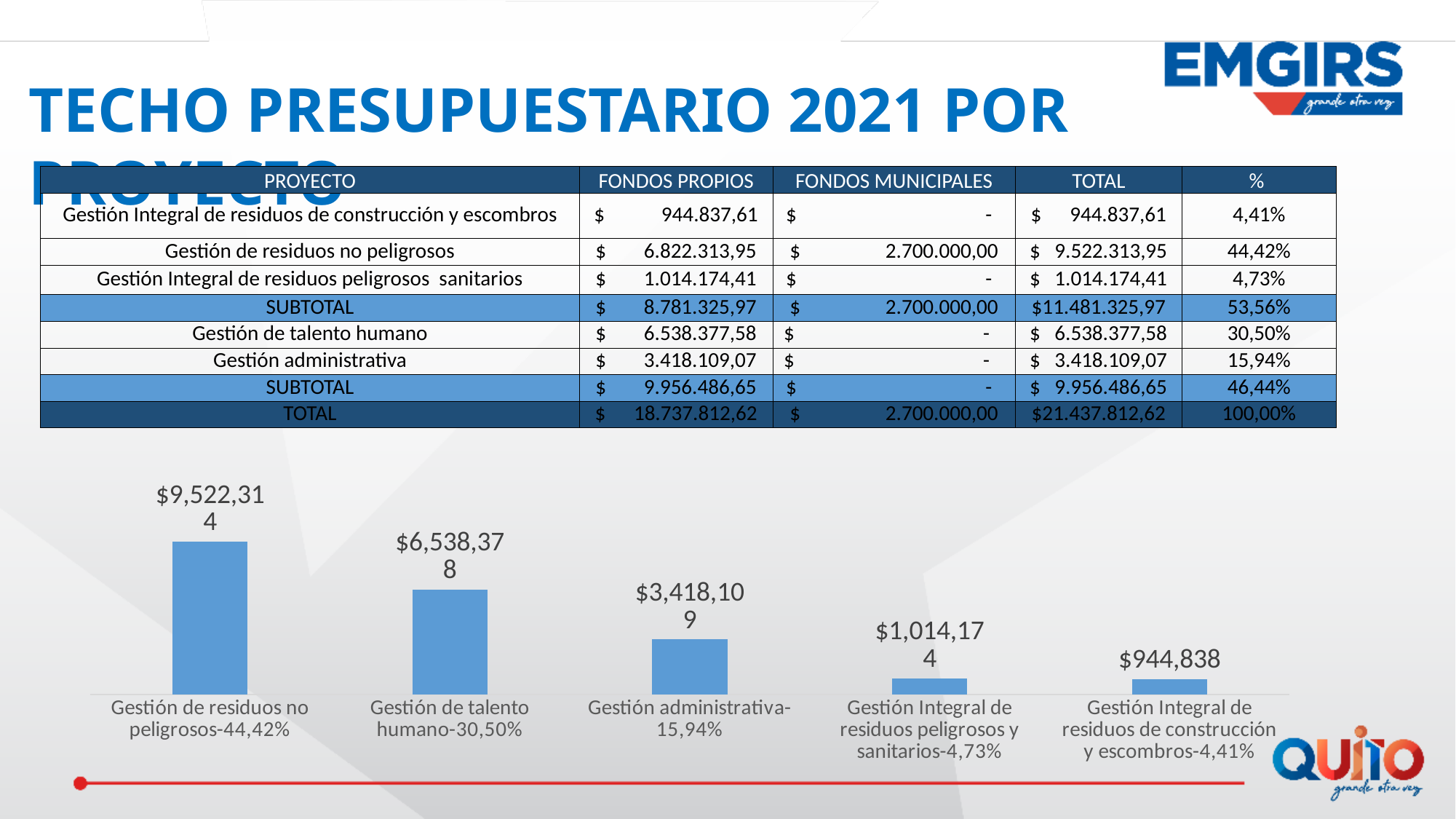
What is the value shown for Gestión administrativa in the bar chart? $3,418,109 What is the value shown for Gestión Integral de residuos de construcción y escombros in the bar chart? $944,838 What is the value shown for Gestión de residuos no peligrosos in the bar chart? $9,522,314 Which category has the lowest bar in the chart? Gestión Integral de residuos de construcción y escombros What is the value shown for Gestión de talento humano in the bar chart? $6,538,378 Do the bar values rise or fall from left to right across the chart? Fall What is the difference between the bar values for Gestión de residuos no peligrosos and Gestión de talento humano? $2,983,936 What type of chart is shown below the table? Bar chart Which category has the highest bar in the chart? Gestión de residuos no peligrosos What is the difference between the bar values for Gestión de talento humano and Gestión administrativa? $3,120,269 Which is larger in the bar chart: Gestión administrativa or Gestión Integral de residuos peligrosos y sanitarios? Gestión administrativa How many bars are shown in the chart? 5